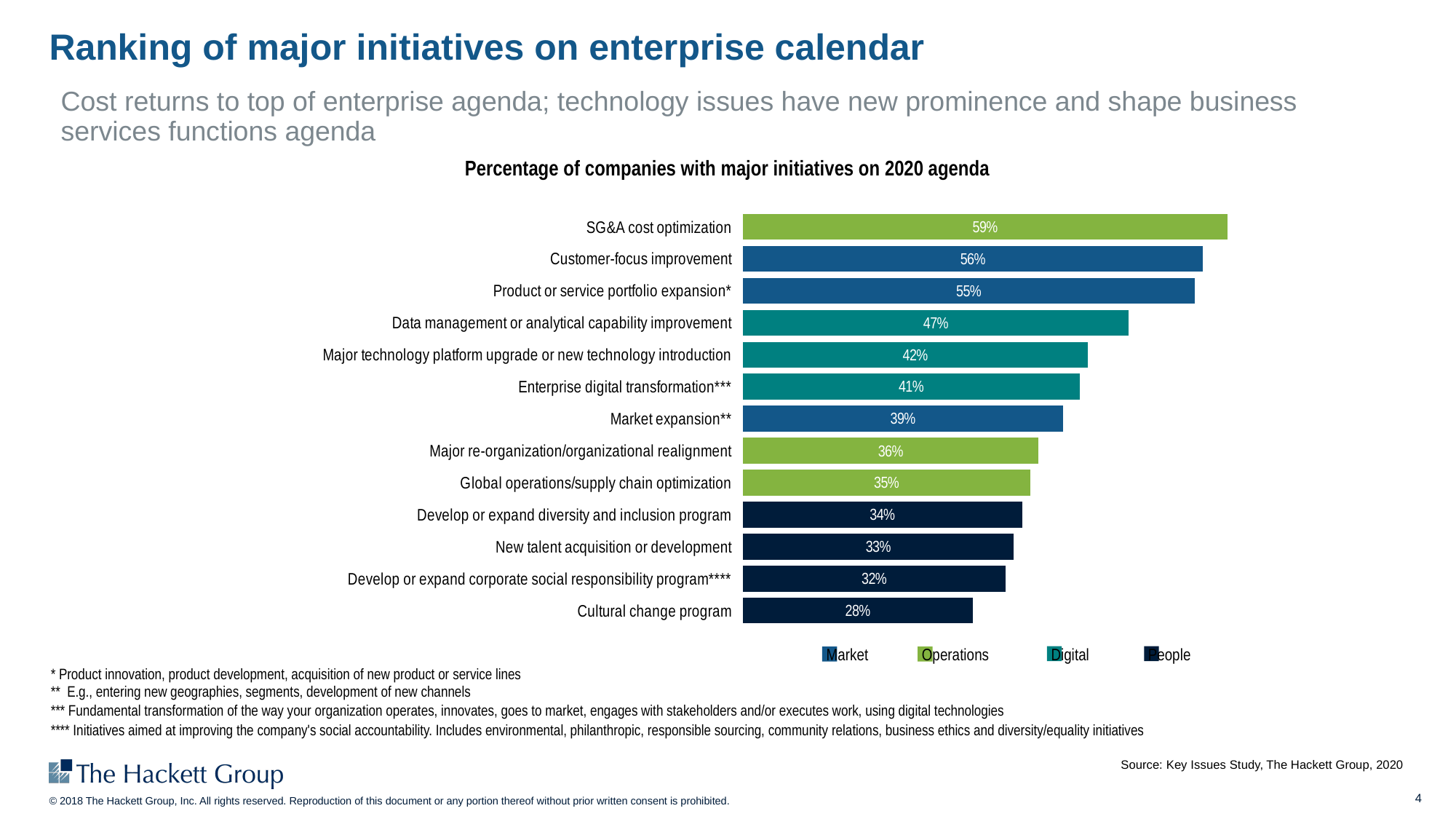
What is the difference in percentage points between Data management or analytical capability improvement and Market expansion**? 8 What is the title of the chart? Percentage of companies with major initiatives on 2020 agenda What percentage is shown for Cultural change program? 28% What percentage of companies have SG&A cost optimization on their 2020 agenda? 59% Which initiative has the highest percentage of companies? SG&A cost optimization What type of chart is shown on the slide? Bar chart What is the value shown for Enterprise digital transformation***? 41% How many categories does the legend list? 4 What is the difference in percentage points between SG&A cost optimization and Customer-focus improvement? 3 Which is larger: the value for Major technology platform upgrade or new technology introduction, or the value for Global operations/supply chain optimization? Major technology platform upgrade or new technology introduction How many initiatives are shown in the chart? 13 Which initiative has the lowest percentage of companies? Cultural change program